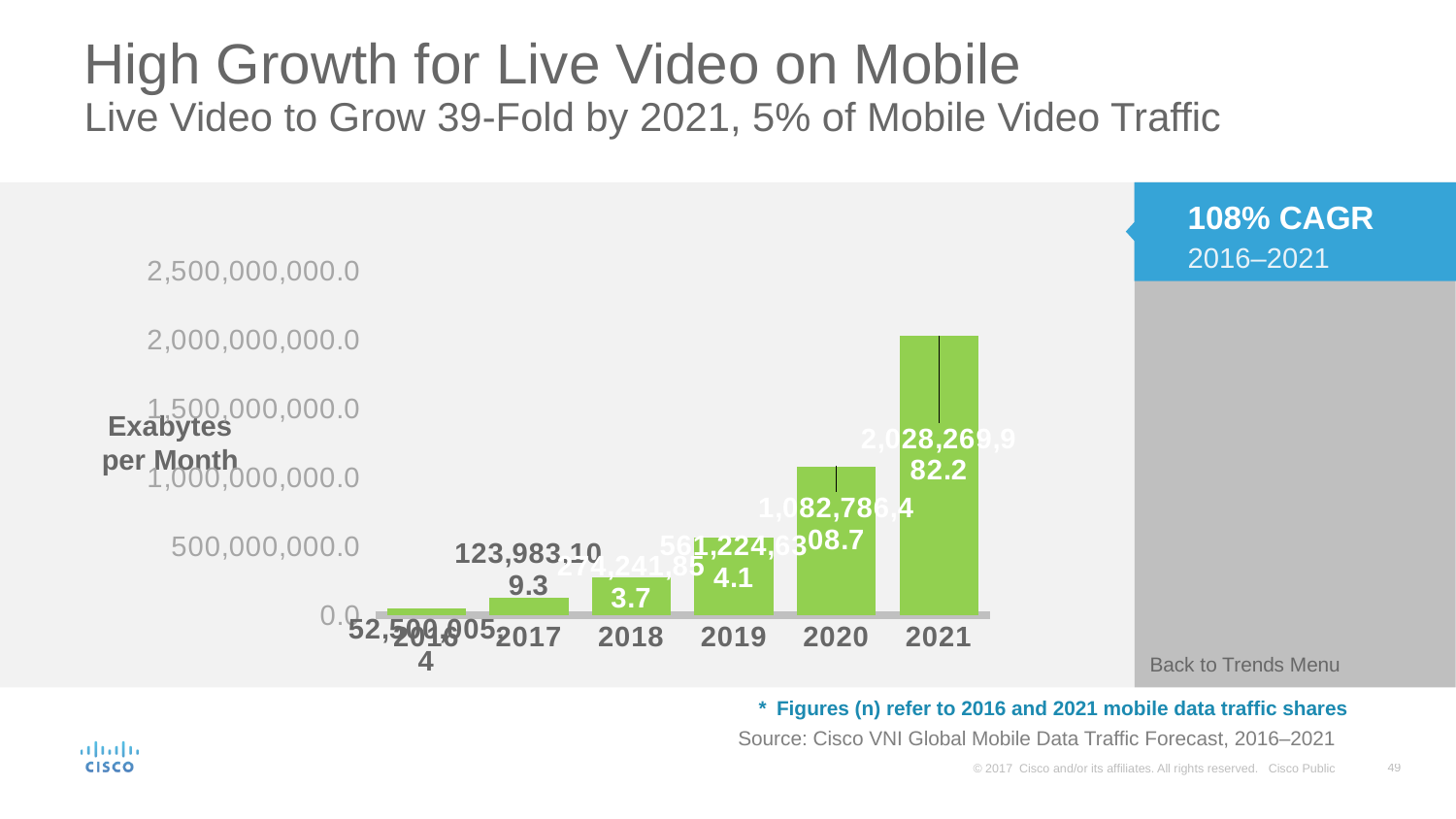
What is the data label value for 2021? 2,028,269,982.2 Which year has the lowest bar in the chart? 2016 Is the value for 2018 greater or less than 500,000,000.0? less Is the value for 2019 greater or less than 1,000,000,000.0? less Which is larger, the value for 2020 or the value for 2019? 2020 Which year has the highest bar in the chart? 2021 What kind of chart is shown on the slide? bar chart Do the values rise or fall from 2016 to 2021? rise How many years are shown on the x axis of the chart? 6 What CAGR for 2016–2021 is stated next to the chart? 108% CAGR What is the data label value for 2017? 123,983,109.3 Is the value for 2021 greater or less than 1,500,000,000.0? greater